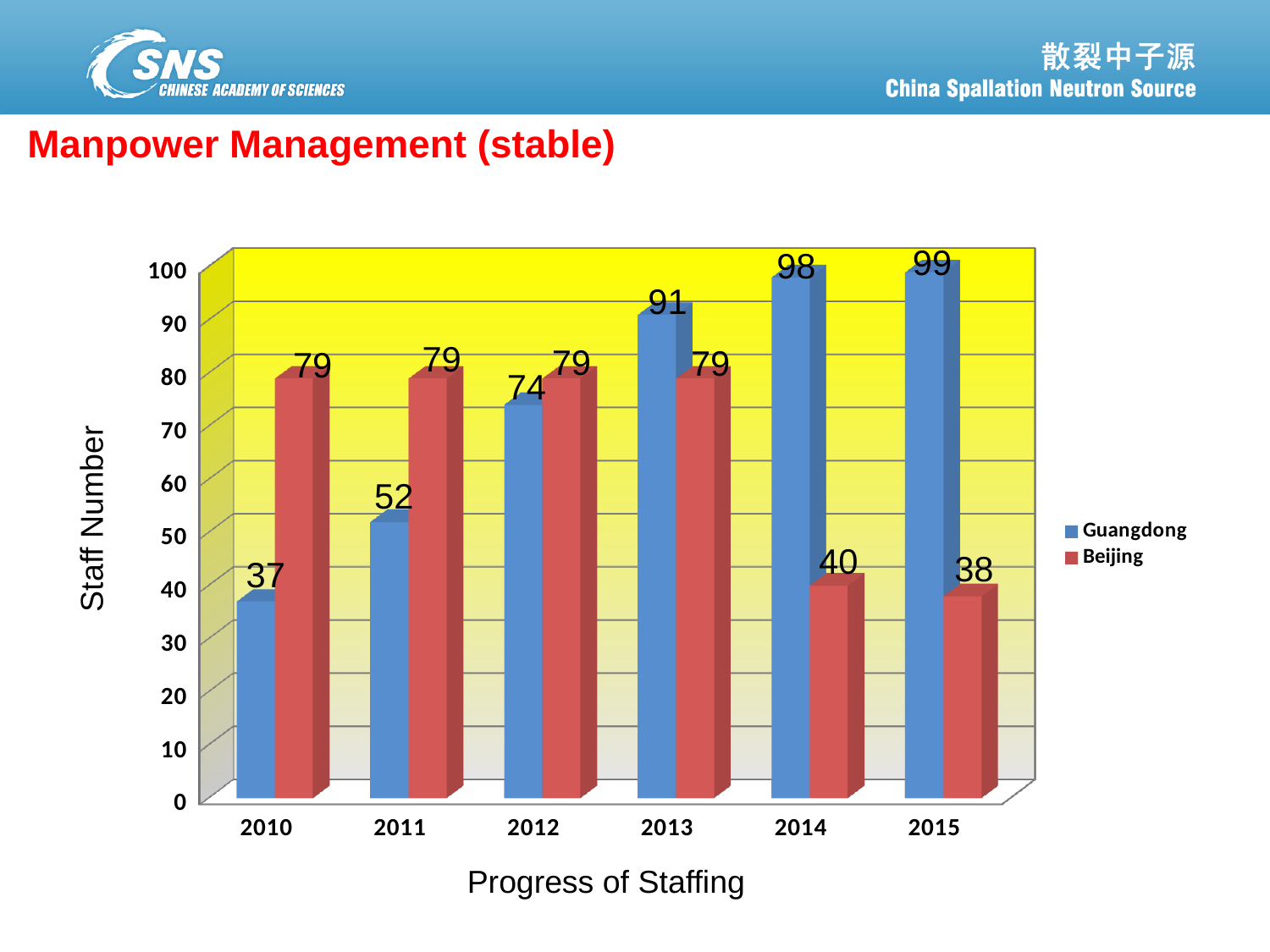
In which year is the Guangdong staff number highest? 2015 How many years are shown on the x axis? 6 Which is larger in 2011, the Guangdong or the Beijing staff number? Beijing What is the difference between the Guangdong and Beijing staff numbers in 2015? 61 How many series does the legend list? 2 In which year is the Beijing staff number lowest? 2015 What is the Guangdong staff number in 2010? 37 Does the Guangdong staff number rise or fall from 2010 to 2015? rise What kind of chart is shown on the slide? bar chart What is the label of the y axis? Staff Number What is the Beijing staff number in 2014? 40 What is the Guangdong staff number in 2013? 91